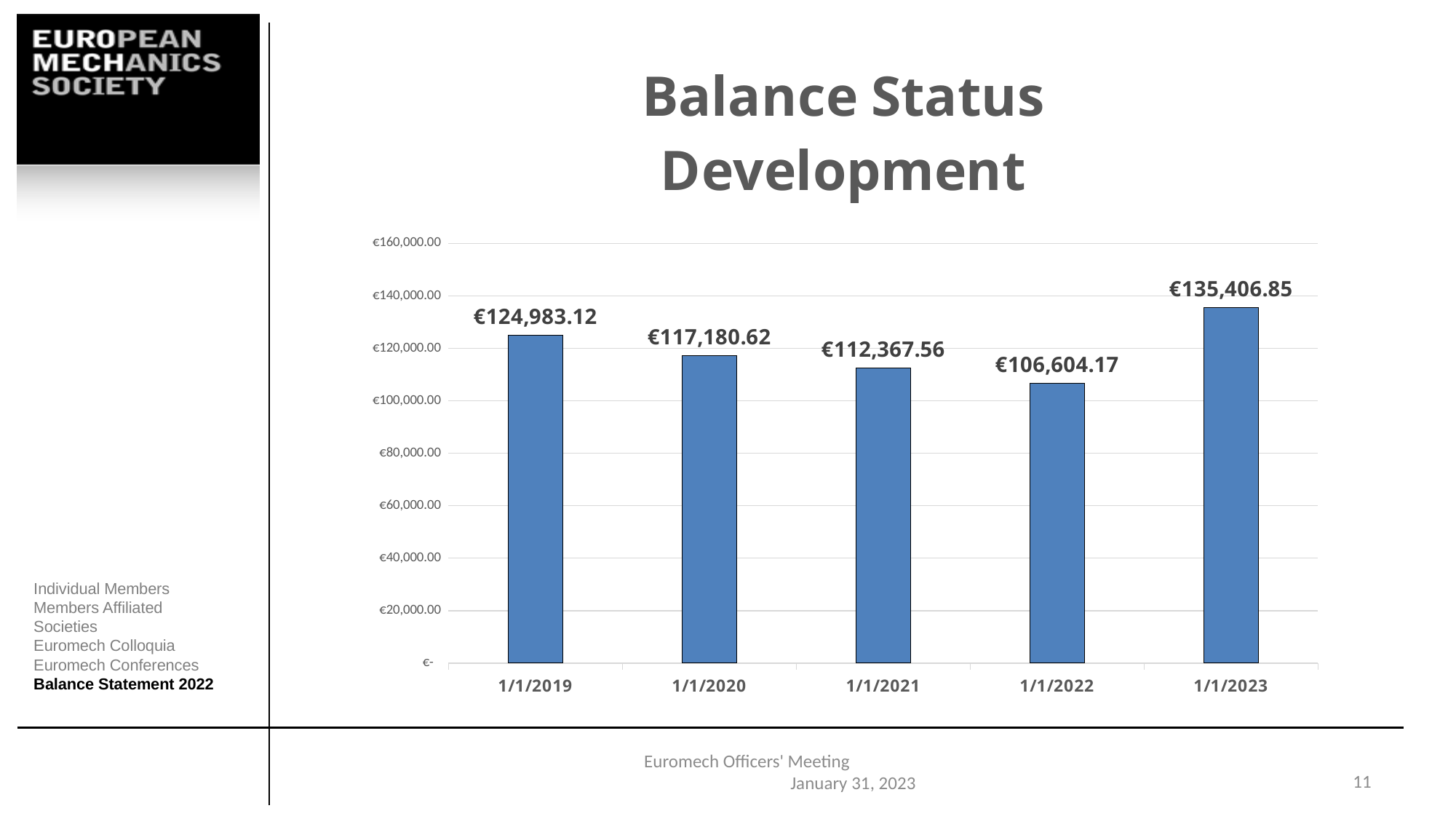
What is the balance shown for 1/1/2019? €124,983.12 Which is larger, the balance on 1/1/2020 or the balance on 1/1/2021? 1/1/2020 Is the balance for 1/1/2021 greater or less than €100,000.00? greater Do the balances rise or fall from 1/1/2019 to 1/1/2022? fall What is the difference between the balance on 1/1/2023 and the balance on 1/1/2022? €28,802.68 What is the difference between the balance on 1/1/2019 and the balance on 1/1/2020? €7,802.50 How many dates are shown on the x axis of the chart? 5 Which date has the highest balance? 1/1/2023 What kind of chart is shown on the slide? bar chart What is the balance shown for 1/1/2023? €135,406.85 Which date has the lowest balance? 1/1/2022 What is the balance shown for 1/1/2022? €106,604.17